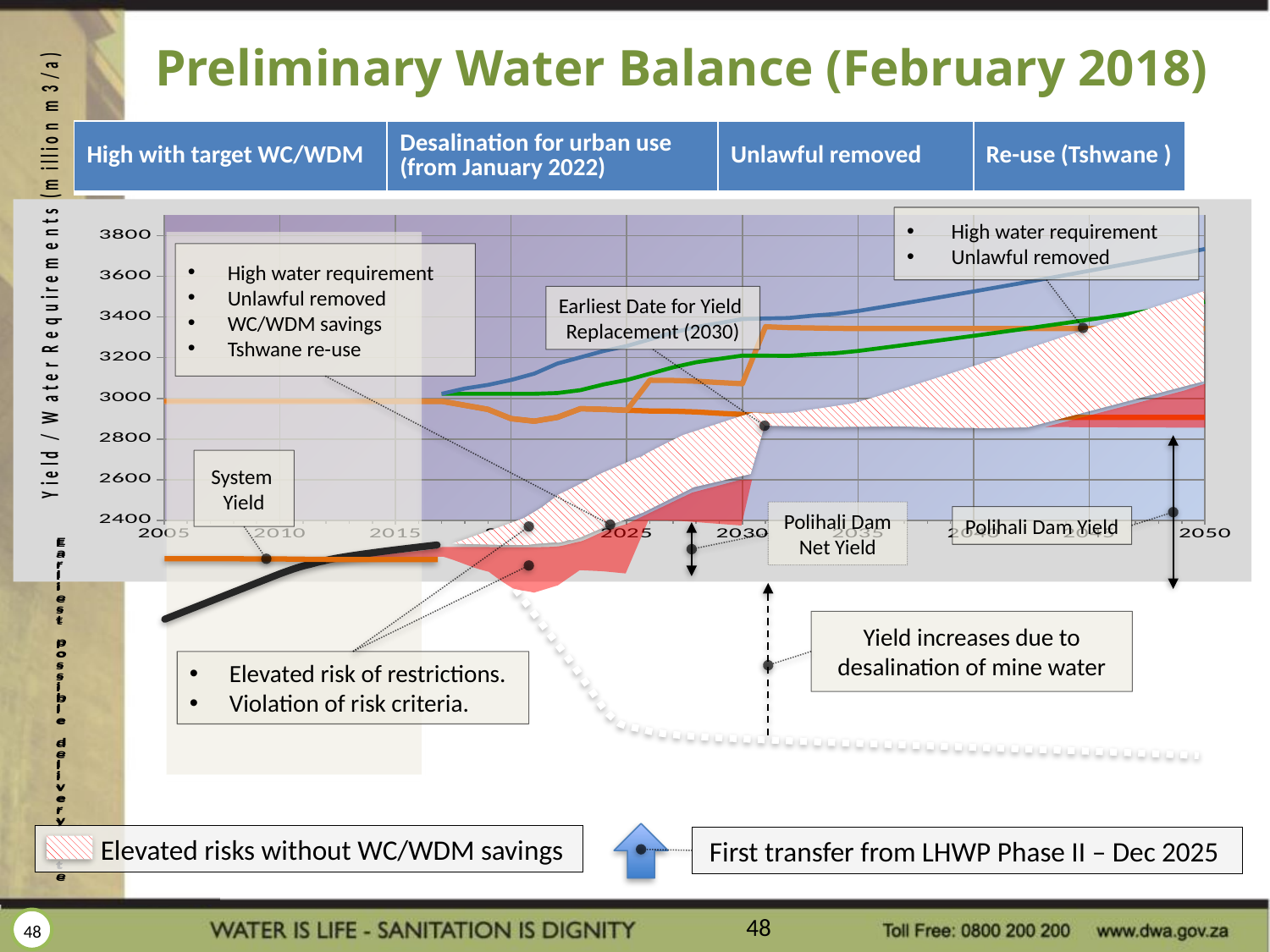
Is the value of the green 'Desalination for urban use' line at 2050 greater or less than 3200? greater What is the label of the vertical axis? Yield / Water Requirements (million m3/a) What kind of chart is shown on the slide? line chart According to the annotation on the chart, what is the earliest date for yield replacement? 2030 What is the first year shown on the horizontal axis? 2005 How many series are listed in the legend bar above the chart? 4 Does the blue 'High with target WC/WDM' line rise or fall from 2015 to 2050? rise Is the value of the blue 'High with target WC/WDM' line at 2050 greater or less than 3600? greater What is the title of the slide containing the chart? Preliminary Water Balance (February 2018) What is the lowest value shown on the vertical axis? 2400 What is the last year shown on the horizontal axis? 2050 What is the highest value shown on the vertical axis? 3800